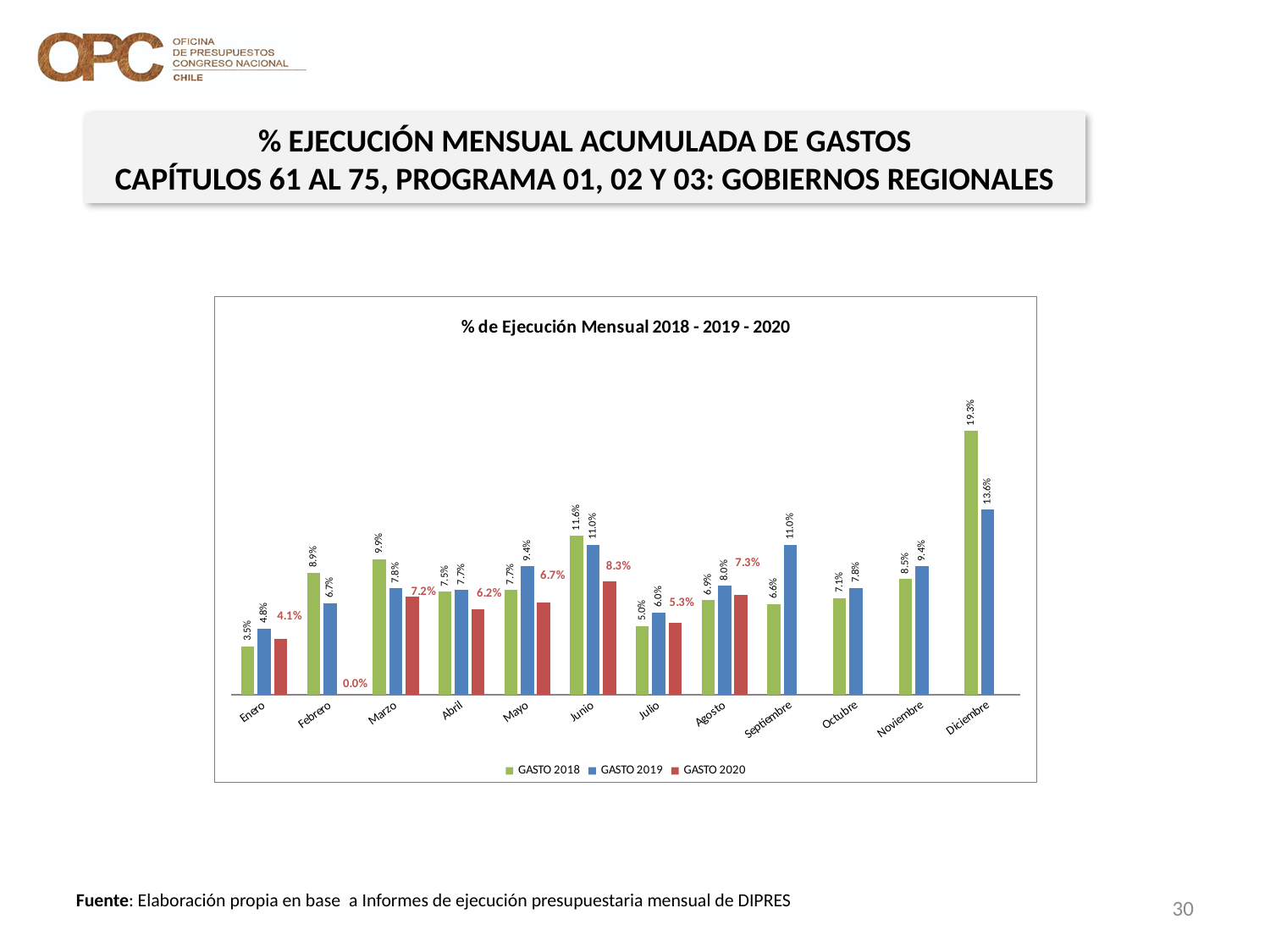
What is the GASTO 2020 value for Febrero? 0.0% What is the GASTO 2019 value for Septiembre? 11.0% How many series does the legend list? 3 Which month has the highest GASTO 2018 value? Diciembre What is the GASTO 2018 value for Diciembre? 19.3% What is the difference between the GASTO 2018 and GASTO 2019 values for Diciembre? 5.7% Which is larger for Mayo, GASTO 2018 or GASTO 2019? GASTO 2019 Which month has the lowest GASTO 2019 value? Enero What is the GASTO 2020 value for Junio? 8.3% What is the title of the chart? % de Ejecución Mensual 2018 - 2019 - 2020 What kind of chart is shown? Bar chart How many months are shown on the x axis? 12